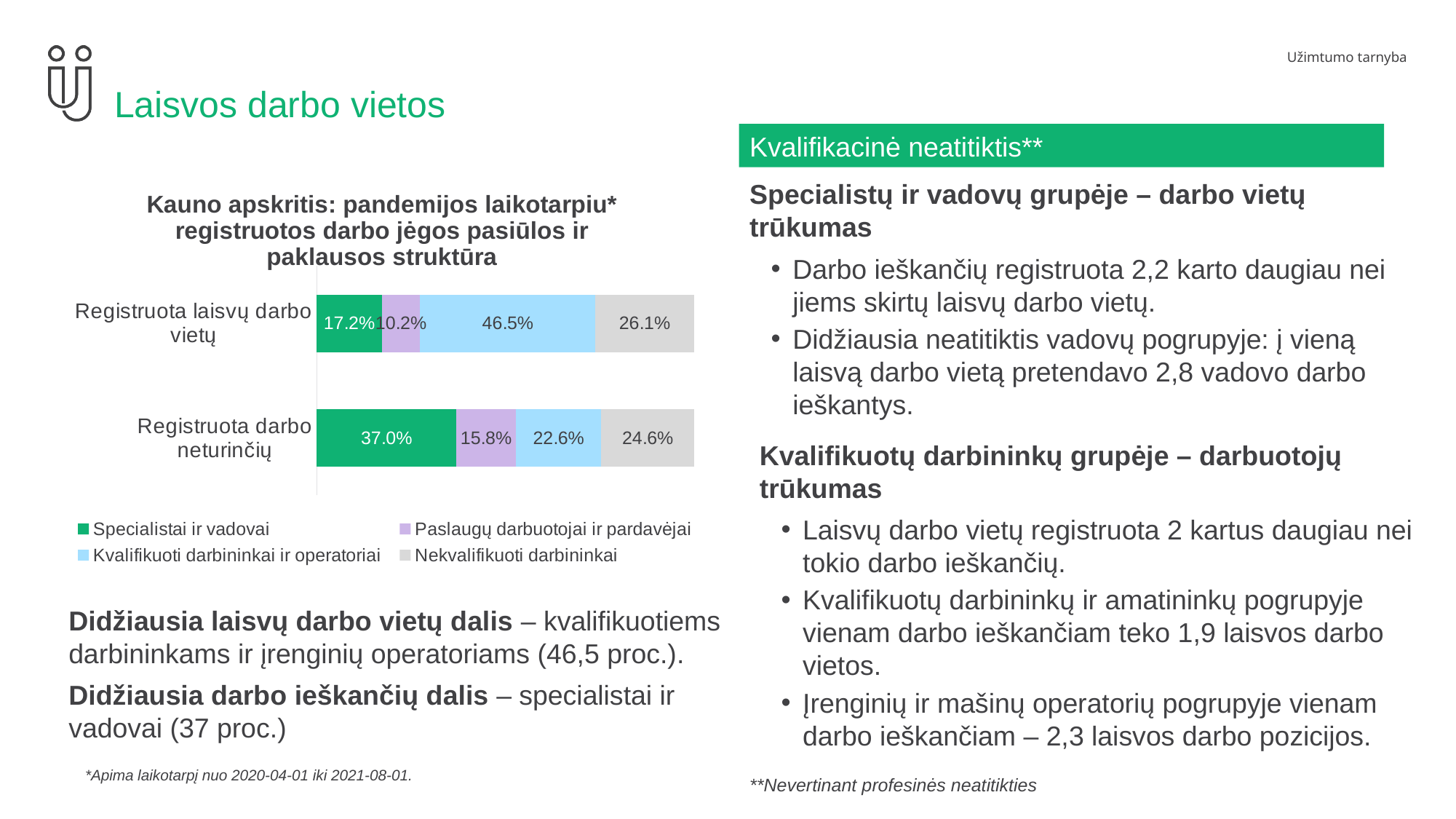
Which series has the smallest share in the Registruota darbo neturinčių bar? Paslaugų darbuotojai ir pardavėjai What is the value for Specialistai ir vadovai in the Registruota laisvų darbo vietų bar? 17.2% What is the value for Paslaugų darbuotojai ir pardavėjai in the Registruota darbo neturinčių bar? 15.8% What is the value for Kvalifikuoti darbininkai ir operatoriai in the Registruota darbo neturinčių bar? 22.6% How many series does the legend list? 4 What is the value for Nekvalifikuoti darbininkai in the Registruota laisvų darbo vietų bar? 26.1% What type of chart is shown on the slide? Stacked bar chart How many categories (bars) does the chart show? 2 What is the title of the chart? Kauno apskritis: pandemijos laikotarpiu* registruotos darbo jėgos pasiūlos ir paklausos struktūra Which series has the largest share in the Registruota laisvų darbo vietų bar? Kvalifikuoti darbininkai ir operatoriai What is the difference between the Specialistai ir vadovai values for Registruota darbo neturinčių and Registruota laisvų darbo vietų? 19.8% Which bar has the larger value for Nekvalifikuoti darbininkai, Registruota laisvų darbo vietų or Registruota darbo neturinčių? Registruota laisvų darbo vietų